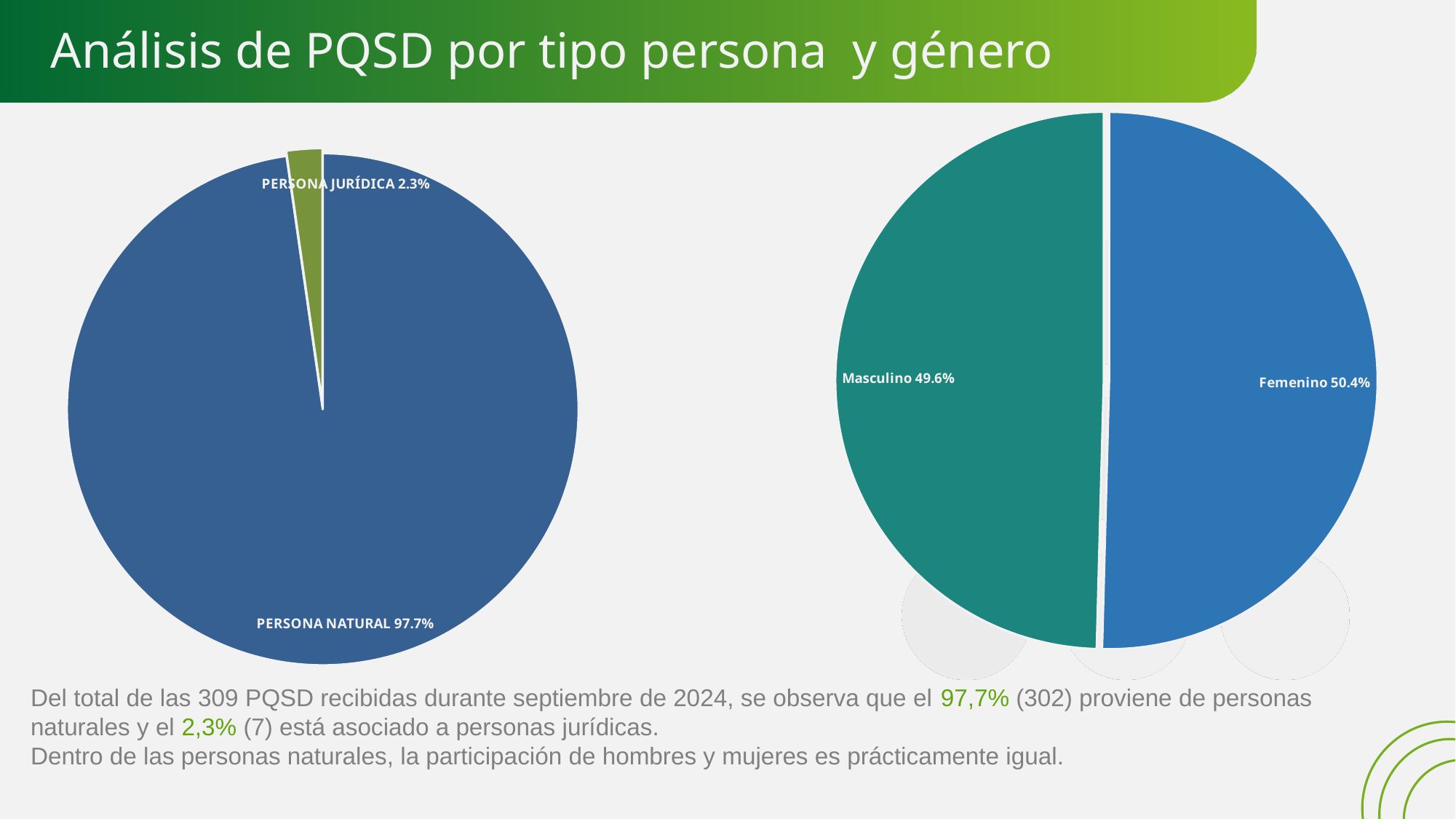
In the right pie chart, what colour is the Masculino slice? teal green In the right pie chart, what is the difference in percentage points between Femenino and Masculino? 0.8 In the left pie chart, what share is labelled for PERSONA JURÍDICA? 2.3% In the left pie chart, what is the difference in percentage points between PERSONA NATURAL and PERSONA JURÍDICA? 95.4 In the left pie chart, what share is labelled for PERSONA NATURAL? 97.7% In the right pie chart, what share is labelled for Masculino? 49.6% In the right pie chart, what share is labelled for Femenino? 50.4% What kind of chart is the chart on the left side of the slide? pie chart In the left pie chart, which slice is the largest? PERSONA NATURAL In the right pie chart, which slice is larger, Masculino or Femenino? Femenino In the left pie chart, which slice is the smallest? PERSONA JURÍDICA How many slices does the left pie chart have? 2